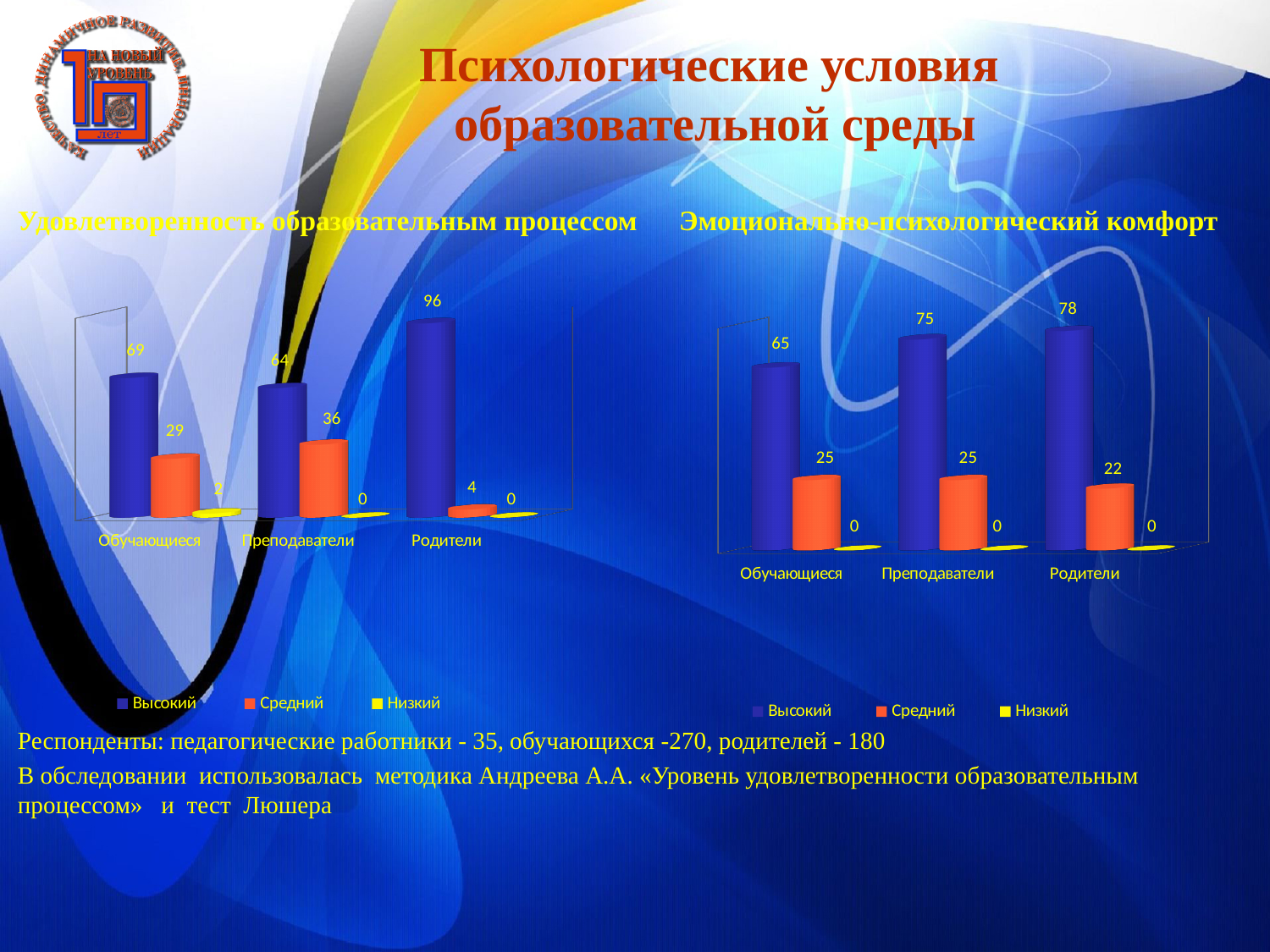
In the chart 'Удовлетворенность образовательным процессом', what is the value of 'Высокий' for 'Родители'? 96 In the chart 'Эмоционально-психологический комфорт', which category has the lowest 'Высокий' value? Обучающиеся What kind of chart is 'Удовлетворенность образовательным процессом'? bar chart In the chart 'Удовлетворенность образовательным процессом', what is the difference between the 'Высокий' values for 'Родители' and 'Преподаватели'? 32 In the chart 'Эмоционально-психологический комфорт', what is the value of 'Средний' for 'Родители'? 22 In the chart 'Эмоционально-психологический комфорт', what is the value of 'Низкий' for 'Обучающиеся'? 0 How many series does the legend of the chart 'Эмоционально-психологический комфорт' list? 3 In the chart 'Эмоционально-психологический комфорт', is the 'Высокий' value for 'Родители' larger or smaller than the 'Высокий' value for 'Преподаватели'? larger How many categories are shown on the x axis of the chart 'Удовлетворенность образовательным процессом'? 3 In the chart 'Удовлетворенность образовательным процессом', what is the value of 'Средний' for 'Преподаватели'? 36 In the chart 'Эмоционально-психологический комфорт', what is the value of 'Высокий' for 'Преподаватели'? 75 In the chart 'Удовлетворенность образовательным процессом', which category has the highest 'Высокий' value? Родители